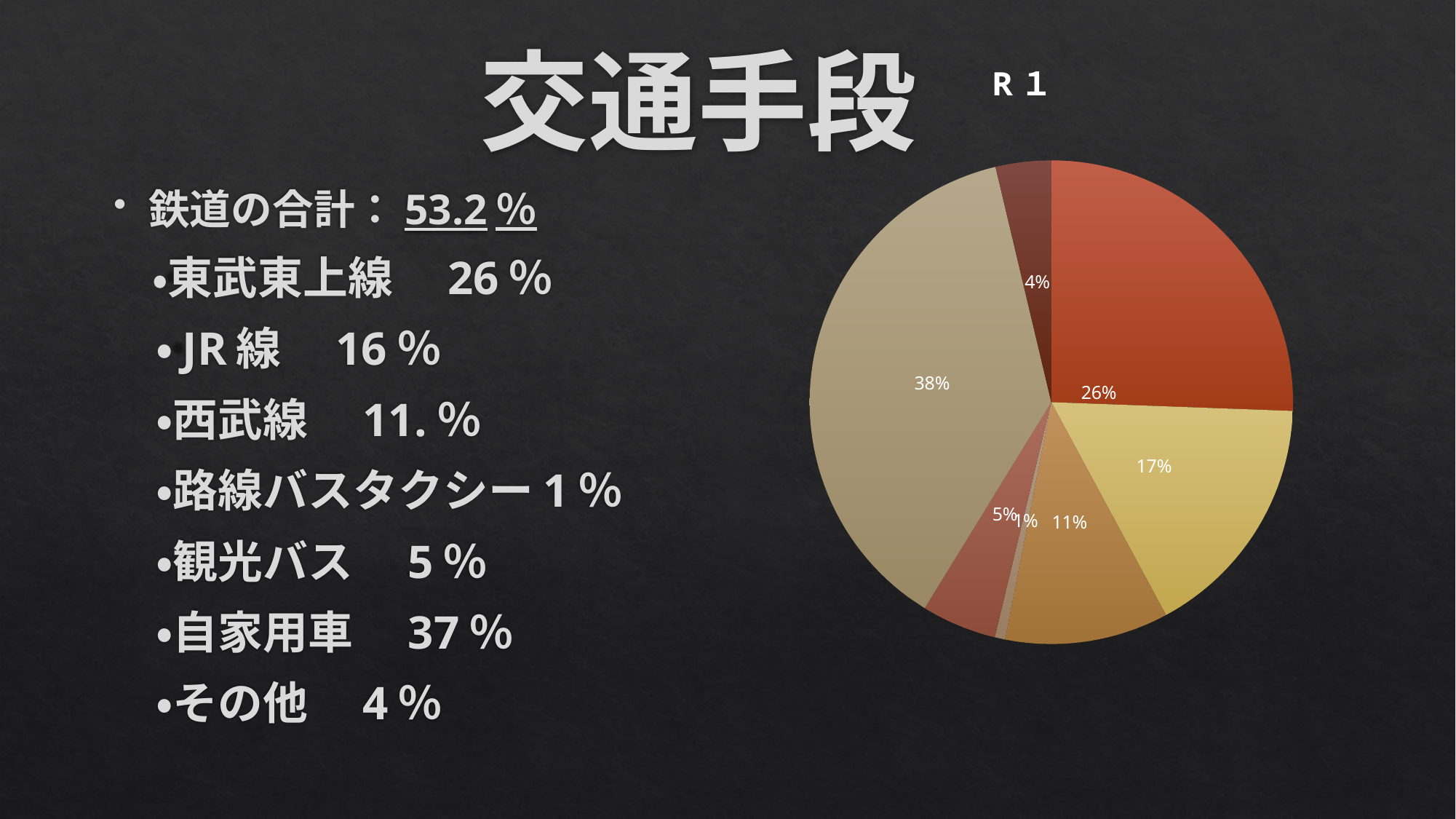
What is the difference in percentage points between the 38% slice and the 26% slice? 12 Does the largest slice of the pie chart account for more or less than half of the pie? less How many slices does the pie chart have? 7 What value is shown on the dark brown slice at the top of the pie chart? 4% What kind of chart is shown on the slide? pie chart Which is larger in the pie chart, the yellow slice or the orange-brown slice at the bottom? the yellow slice (17%) What is the data label of the largest slice in the pie chart? 38% What is the title of the slide containing the pie chart? 交通手段 What is the data label of the smallest slice in the pie chart? 1% What short label appears to the right of the slide title, above the pie chart? R 1 What value is shown on the yellow slice of the pie chart? 17% What value is shown on the red slice at the top right of the pie chart? 26%